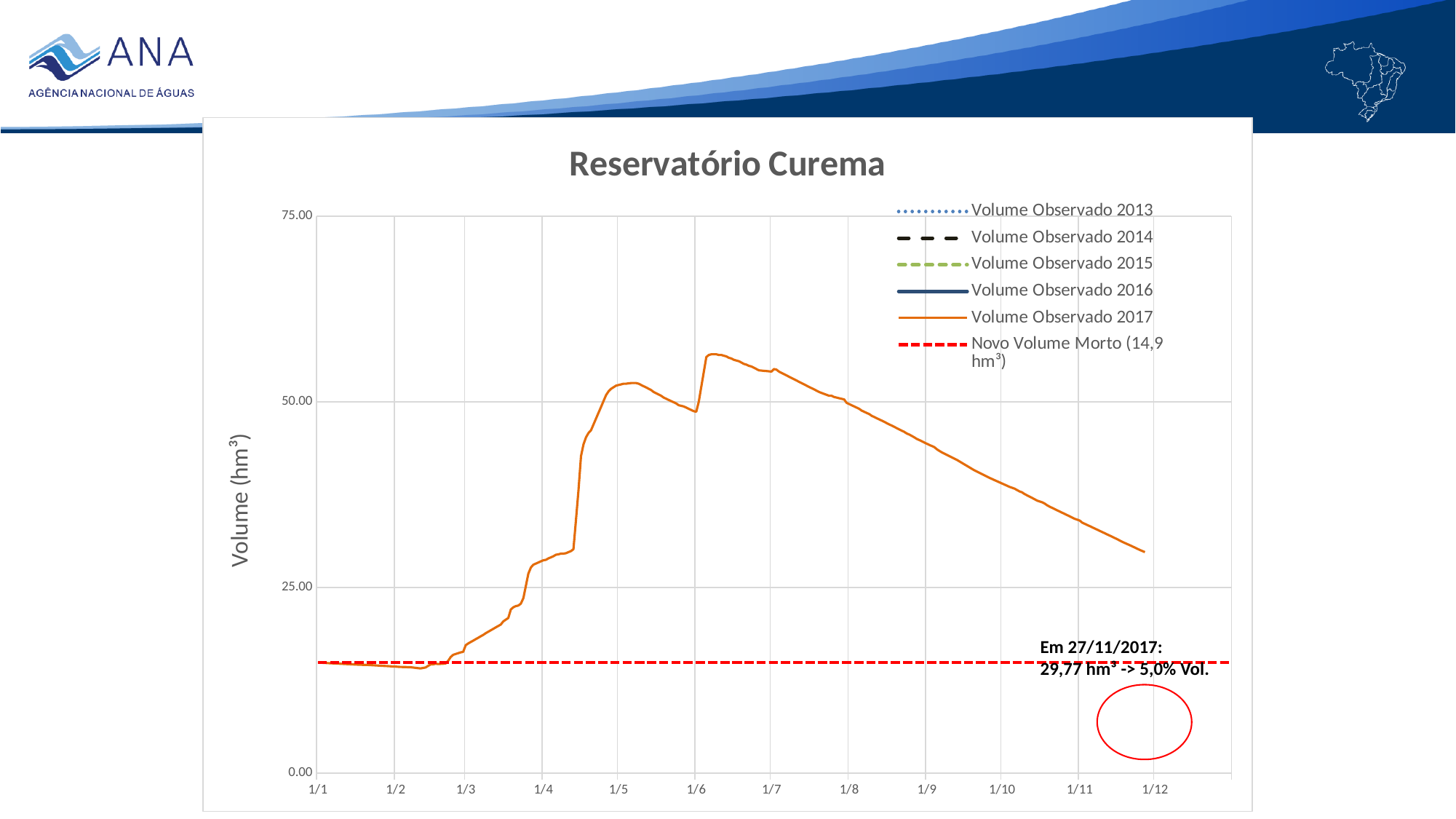
What is the title of the chart? Reservatório Curema Is the Volume Observado 2017 value at 1/9 greater or less than 50? less What kind of chart is shown on the slide? line chart Is the Volume Observado 2017 value at 1/3 greater or less than 25? less According to the annotation, what percentage of volume did the reservoir hold on 27/11/2017? 5,0% Which is larger for Volume Observado 2017: the value at 1/5 or the value at 1/3? 1/5 According to the legend, what is the value of the Novo Volume Morto line? 14,9 hm³ According to the annotation, what was the reservoir volume on 27/11/2017? 29,77 hm³ How many series does the legend of the Reservatório Curema chart list? 6 Does the Volume Observado 2017 line rise or fall between 1/7 and 1/12? fall What is the label of the vertical axis? Volume (hm³) Is the Volume Observado 2017 value at 1/7 greater or less than 50? greater